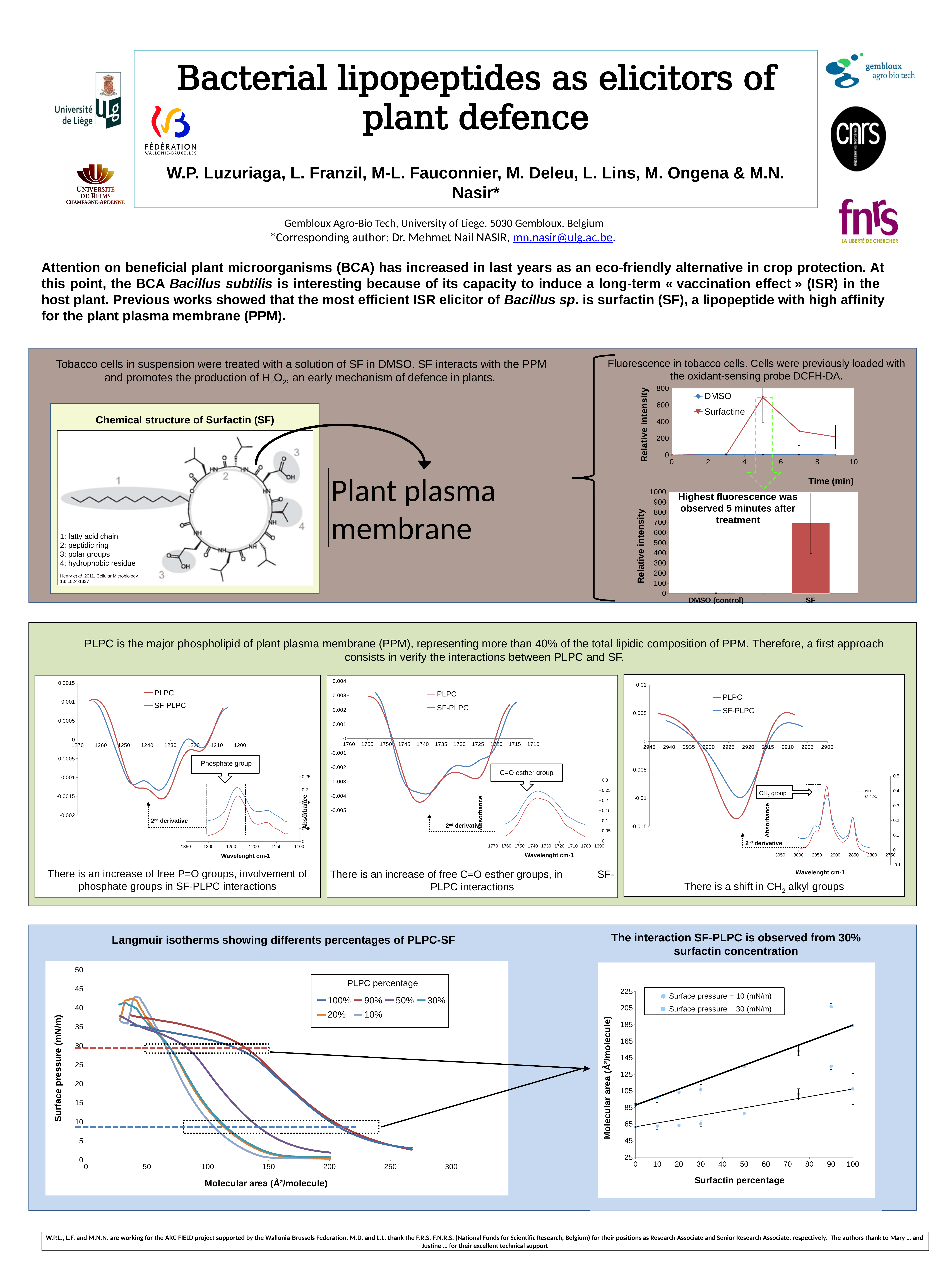
In the Langmuir isotherms chart, how many series does the PLPC percentage legend list? 6 In the Langmuir isotherms chart, what is the title of the y axis? Surface pressure (mN/m) In the fluorescence line chart (top right), which series reaches the higher relative intensity at 5 minutes, DMSO or Surfactine? Surfactine In the fluorescence line chart (top right), is the peak value of the Surfactine series greater or less than 400? greater In the bar chart comparing DMSO (control) and SF, is the value for SF greater or less than 500? greater What kind of chart is the chart comparing DMSO (control) and SF relative intensity? bar chart In the bar chart comparing DMSO (control) and SF, which category has the higher relative intensity? SF In the fluorescence line chart (top right, Relative intensity vs Time), how many series does the legend list? 2 In the bar chart comparing DMSO (control) and SF, how many categories are shown on the x axis? 2 In the leftmost FTIR chart (Phosphate group), what are the two series listed in the legend? PLPC and SF-PLPC In the scatter chart of Molecular area vs Surfactin percentage, does molecular area rise or fall as surfactin percentage increases? rise In the Langmuir isotherms chart, does surface pressure rise or fall as molecular area increases along the x axis? fall